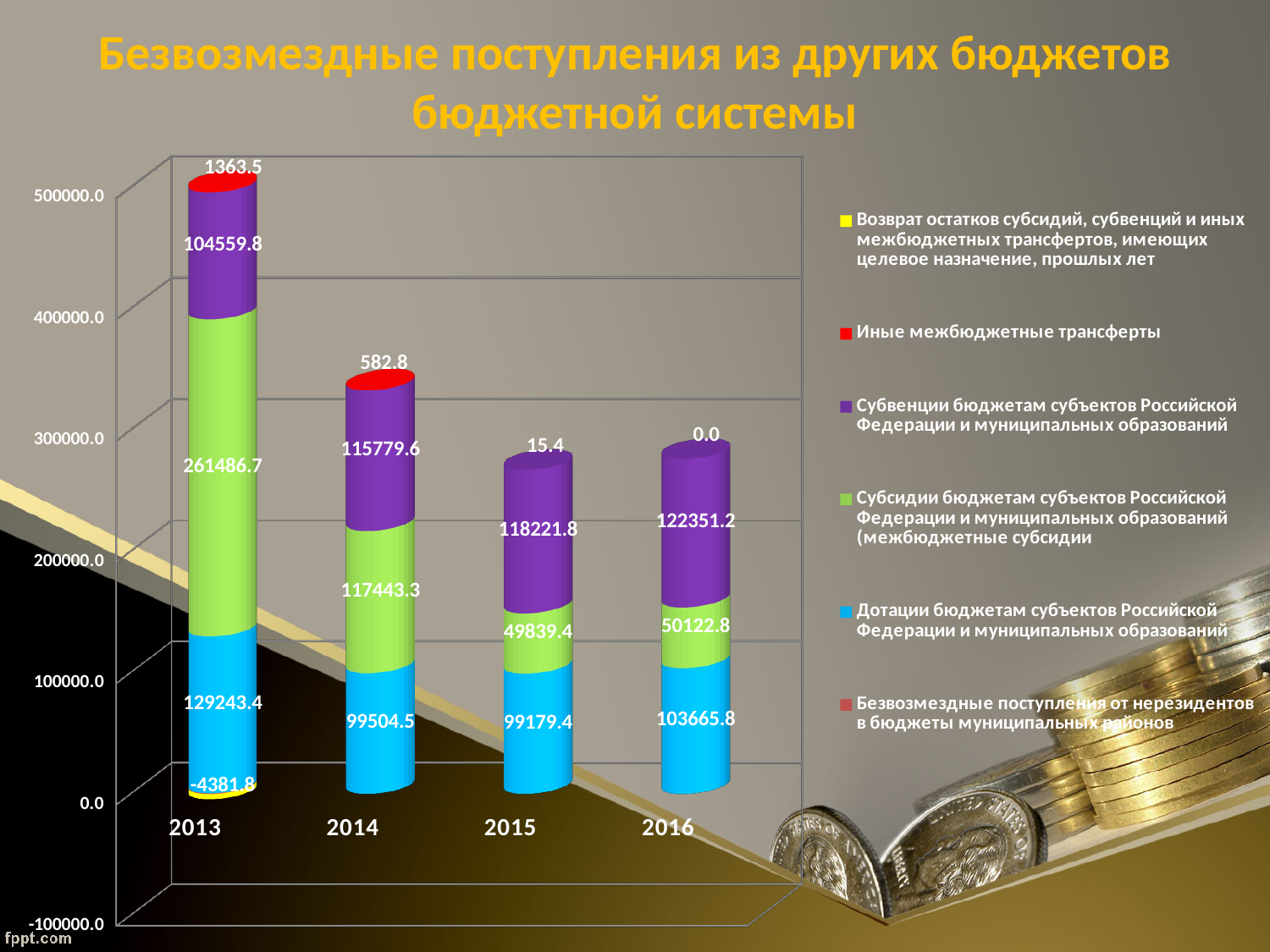
How many years are shown on the x axis? 4 Which is larger: the Субвенции value for 2014 or for 2015? 2015 What is the value of the Субвенции бюджетам субъектов Российской Федерации и муниципальных образований series for 2016? 122351.2 In which year is the Субсидии бюджетам субъектов Российской Федерации и муниципальных образований series highest? 2013 What is the value of the Дотации бюджетам субъектов Российской Федерации и муниципальных образований series for 2013? 129243.4 Is the total stacked value for 2015 greater or less than 300000.0? less What is the value of the Субсидии бюджетам субъектов Российской Федерации и муниципальных образований series for 2015? 49839.4 What kind of chart is shown on the slide? stacked bar chart How many series does the legend list? 6 What is the value of the Иные межбюджетные трансферты series for 2014? 582.8 What is the difference between the Субсидии values for 2013 and 2014? 144043.4 In which year is the Дотации бюджетам субъектов Российской Федерации и муниципальных образований series lowest? 2015